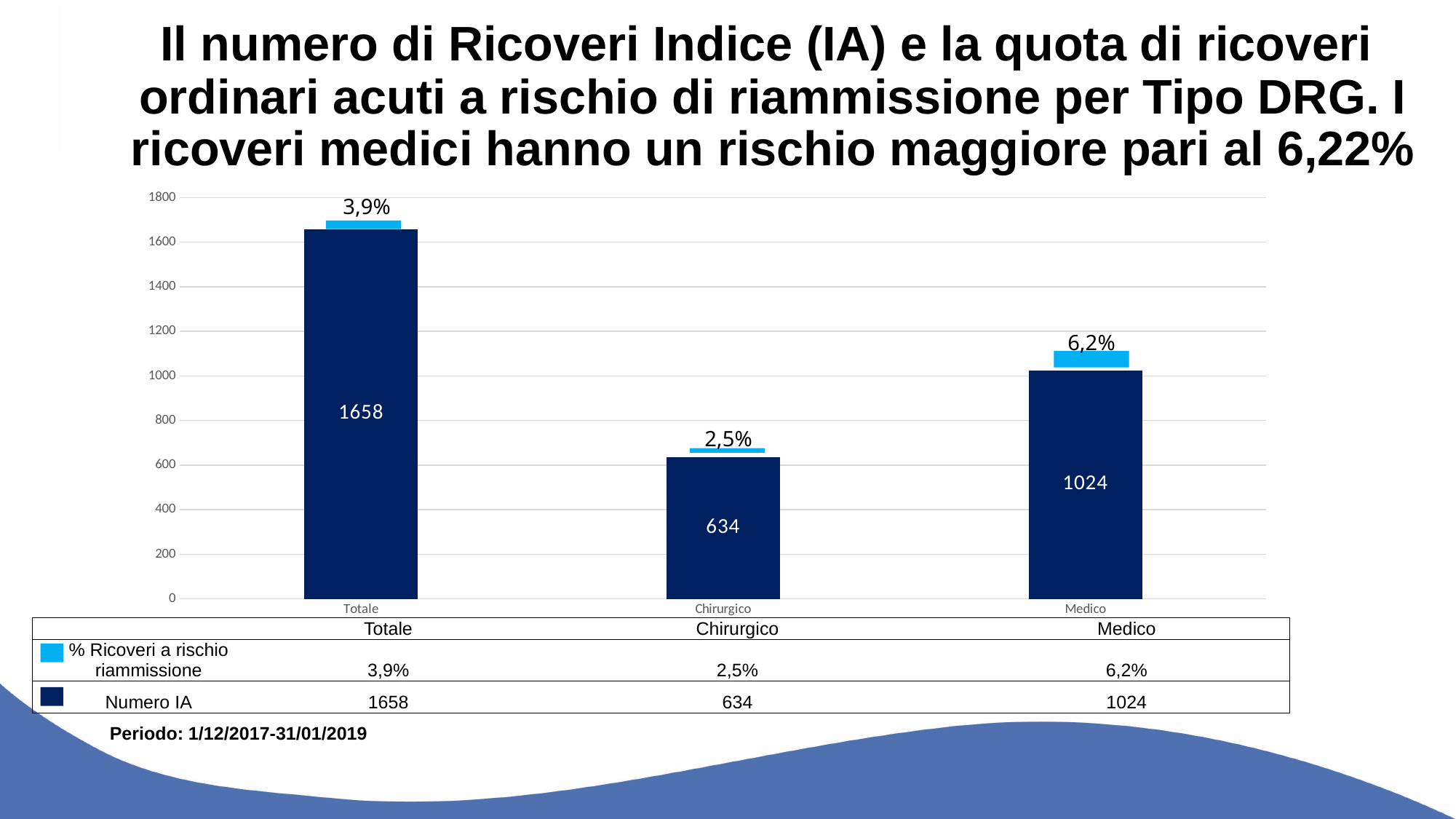
How many categories are shown on the x axis? 3 How many series does the legend list? 2 What is the Numero IA value for Totale? 1658 What kind of chart is shown on the slide? Bar chart What is the Numero IA value for Chirurgico? 634 Which has a larger Numero IA, Chirurgico or Medico? Medico Which category has the lowest Numero IA? Chirurgico What is the % Ricoveri a rischio riammissione for Medico? 6,2% What is the Numero IA value for Medico? 1024 What is the difference in Numero IA between Medico and Chirurgico? 390 What is the % Ricoveri a rischio riammissione for Chirurgico? 2,5% Which category has the highest % Ricoveri a rischio riammissione? Medico